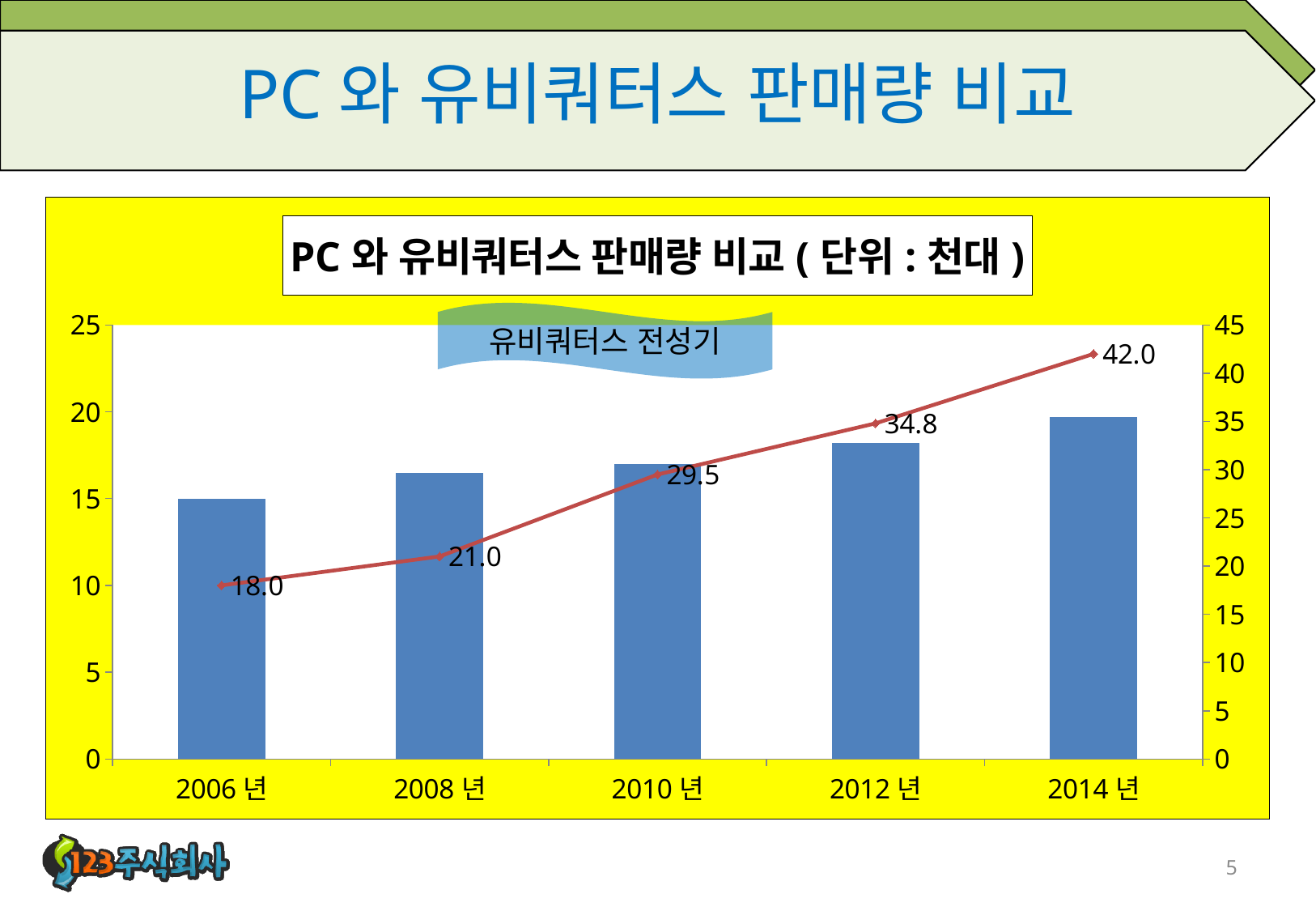
Does the line series rise or fall from 2006 년 to 2014 년? rise What is the difference between the line series values for 2014 년 and 2006 년? 24.0 What is the title of the chart? PC 와 유비쿼터스 판매량 비교 ( 단위 : 천대 ) What is the value of the line series for 2010 년? 29.5 What is the value of the line series for 2006 년? 18.0 In which year does the line series have its lowest value? 2006 년 In which year does the line series reach its highest value? 2014 년 What is the value of the line series for 2014 년? 42.0 Which is larger for the line series: the value for 2008 년 or the value for 2012 년? 2012 년 Is the bar for 2012 년 greater or less than 15 on the left axis? greater How many years are shown on the x axis? 5 What is the value of the line series for 2012 년? 34.8